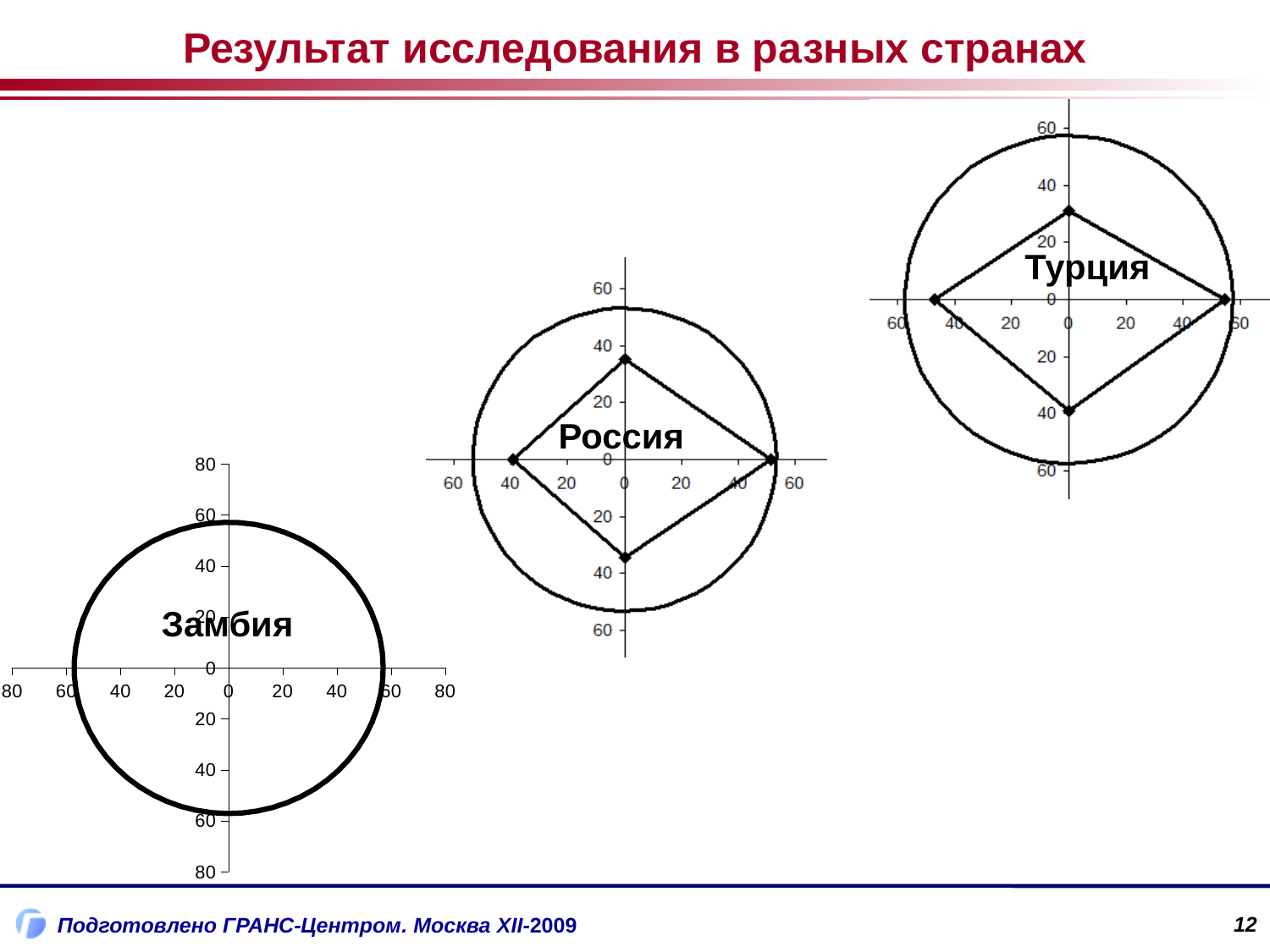
On the Турция chart, how many data points does the inner diamond shape have? 4 What is the highest axis tick value shown on the Россия chart? 60 On the Россия chart, how many data points does the inner diamond shape have? 4 Which of the three charts shows only a circle with no inner diamond of data points? Замбия How many charts are shown on the slide? 3 On the Россия chart, is the value of the top data point greater or less than 40? less Which countries are named on the three charts? Замбия, Россия, Турция On the Россия chart, is the value of the right data point greater or less than 40? greater On the Турция chart, is the value of the right data point greater or less than 40? greater On the Россия chart, which is larger: the value of the right data point or the value of the top data point? the right data point What is the highest axis tick value shown on the Замбия chart? 80